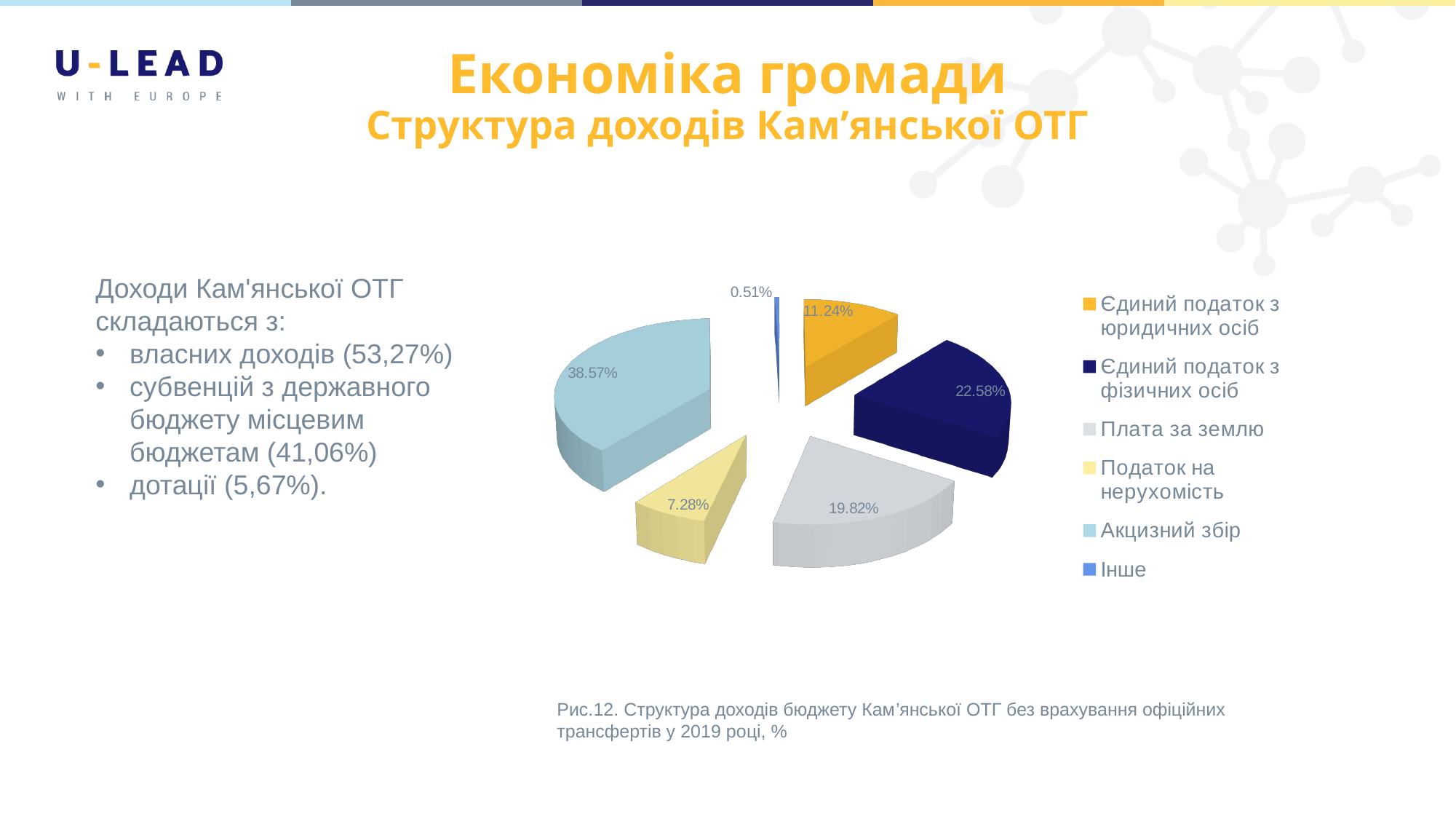
Which category has the largest slice of the pie? Акцизний збір What share of the pie does Акцизний збір have? 38.57% Which colour represents Акцизний збір in the legend? Light blue What is the value shown for Єдиний податок з фізичних осіб? 22.58% How many categories does the pie chart have? 6 Which is larger: the share of Плата за землю or the share of Податок на нерухомість? Плата за землю What is the value shown for Інше? 0.51% Which category has the smallest slice of the pie? Інше What is the value shown for Плата за землю? 19.82% What kind of chart is shown on the slide? Pie chart What is the difference between the shares of Єдиний податок з фізичних осіб and Єдиний податок з юридичних осіб? 11.34% What is the value shown for Податок на нерухомість? 7.28%